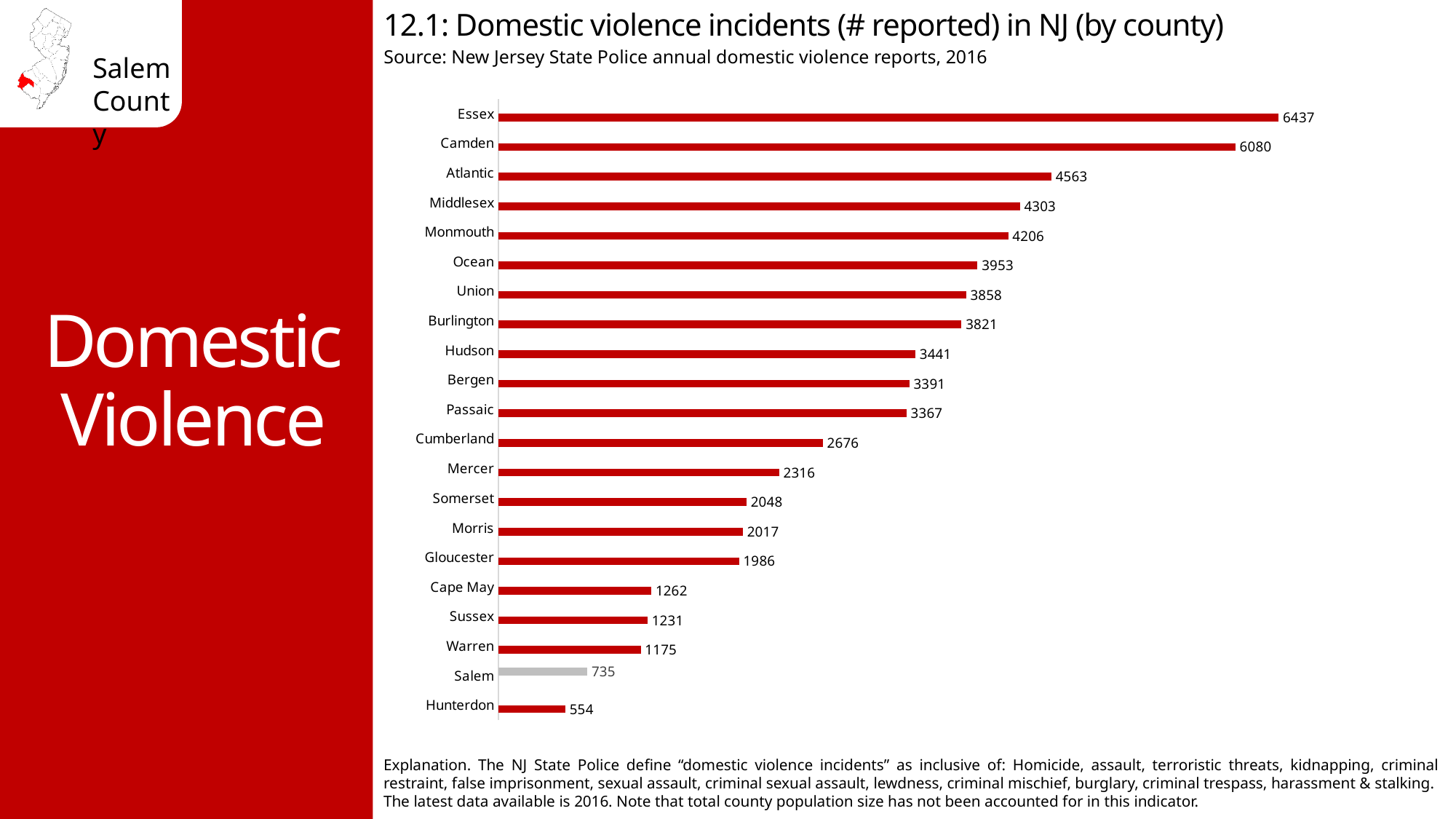
Which county has more reported incidents, Atlantic or Middlesex? Atlantic What is the number of reported domestic violence incidents for Essex county? 6437 Which county's bar is shown in grey rather than red? Salem What is the difference between the number of incidents in Essex and Camden? 357 How many counties are shown in the chart? 21 What is the difference between the number of incidents in Salem and Hunterdon? 181 Which county has the highest number of reported domestic violence incidents? Essex What kind of chart is shown on the slide? Bar chart Which county has more reported incidents, Gloucester or Cape May? Gloucester What is the number of reported domestic violence incidents for Salem county? 735 What is the number of reported domestic violence incidents for Cumberland county? 2676 Which county has the lowest number of reported domestic violence incidents? Hunterdon